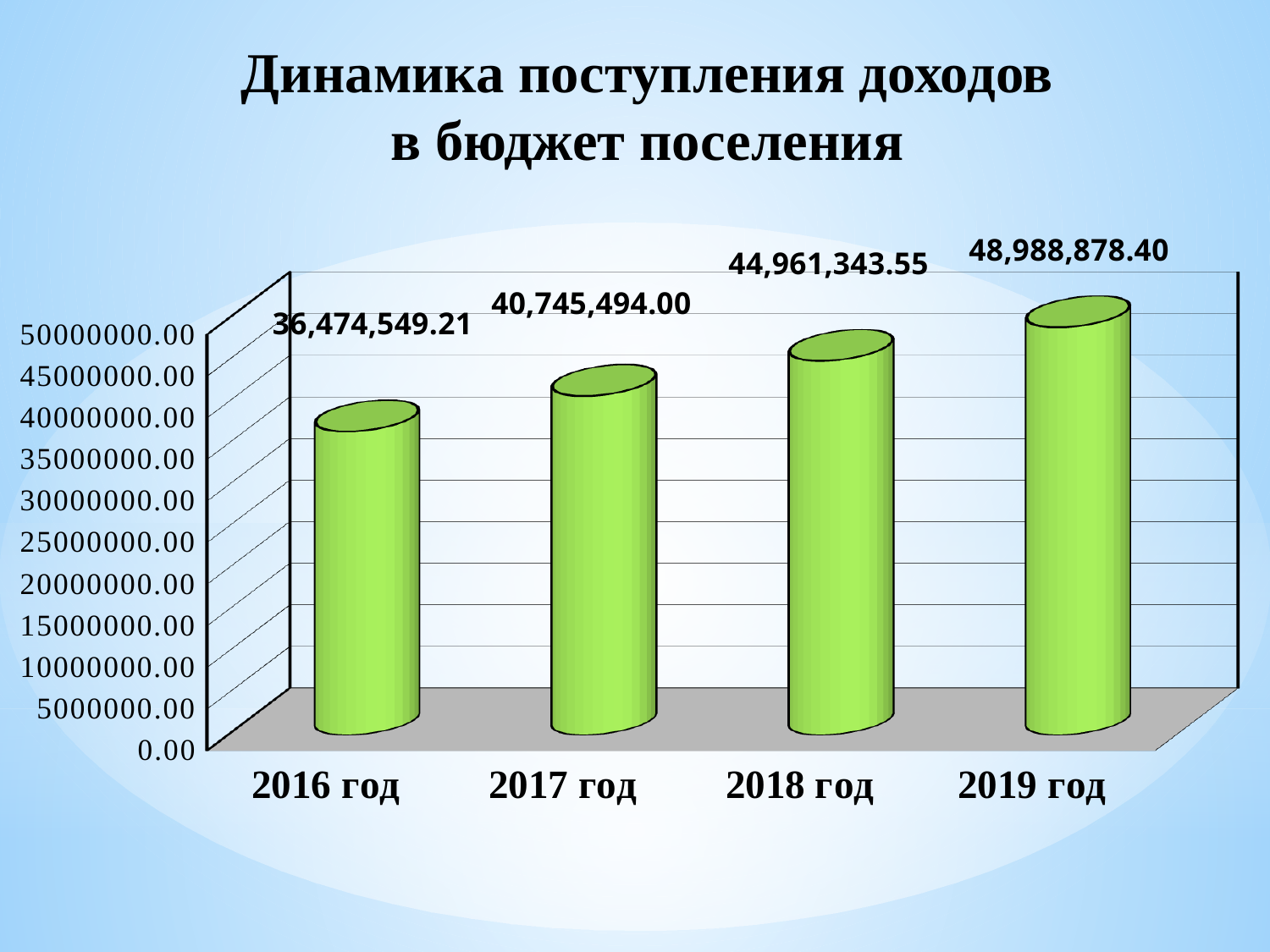
What is the value for 2019 год? 48,988,878.40 Which year has the highest value? 2019 год What kind of chart is shown on the slide? Bar chart What is the value for 2016 год? 36,474,549.21 What is the value for 2017 год? 40,745,494.00 Do the values rise or fall from 2016 год to 2019 год? Rise What is the difference between the values for 2019 год and 2016 год? 12,514,329.19 How many years are shown on the chart? 4 What is the value for 2018 год? 44,961,343.55 What is the difference between the values for 2017 год and 2016 год? 4,270,944.79 Which year has the lowest value? 2016 год Which is larger, the value for 2018 год or the value for 2017 год? 2018 год